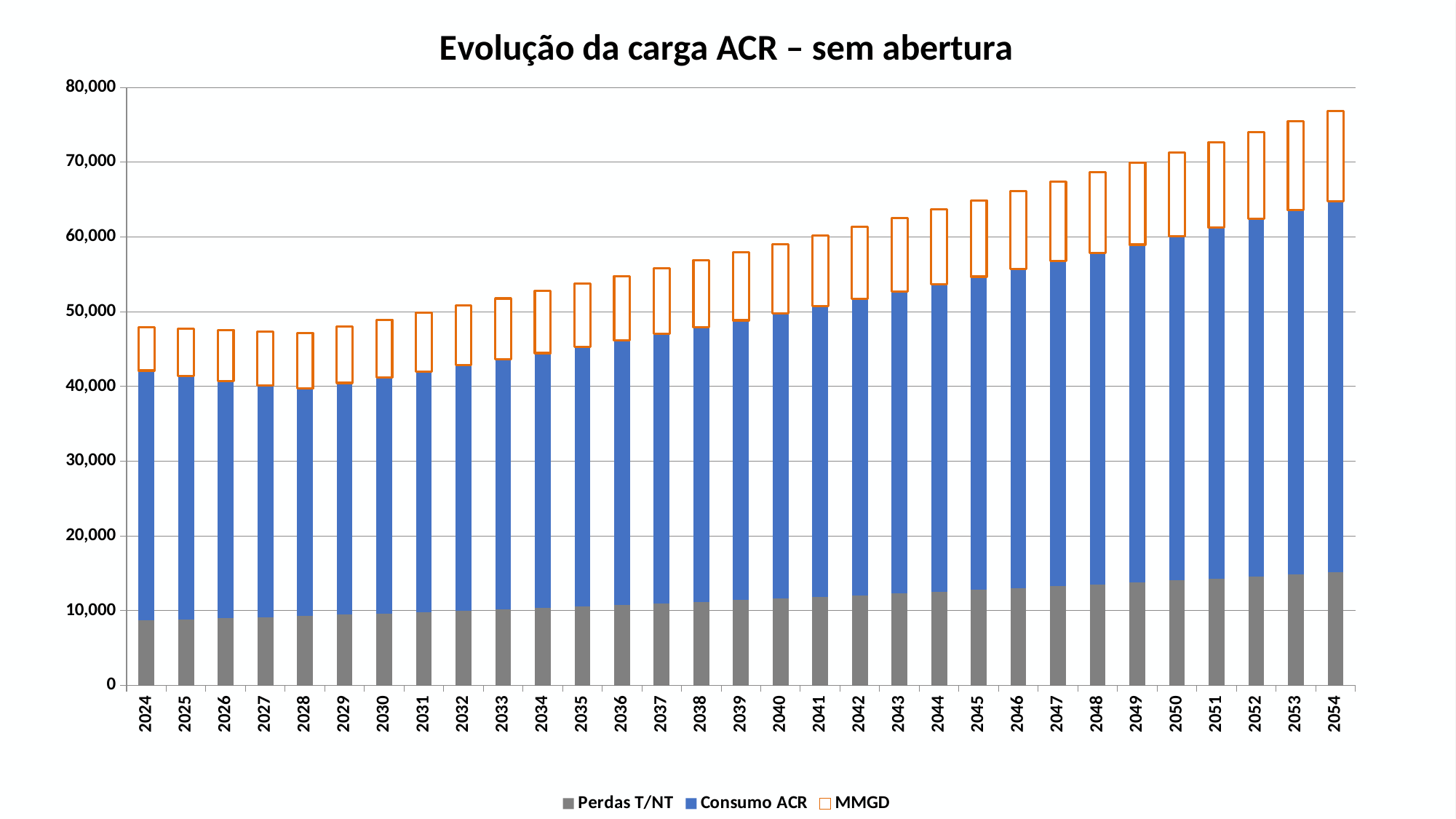
How many years are shown on the x axis? 31 Is the total stacked value for 2024 greater or less than 50,000? less Which has the larger total stacked value, 2024 or 2054? 2054 How many series does the legend list? 3 What kind of chart is shown on the slide? stacked bar chart Is the total stacked value for 2038 greater or less than 60,000? less What is the title of the chart? Evolução da carga ACR – sem abertura Which year has the tallest stacked bar? 2054 Is the Perdas T/NT value for 2024 greater or less than 10,000? less Do the total stacked values generally rise or fall from 2030 to 2054? rise